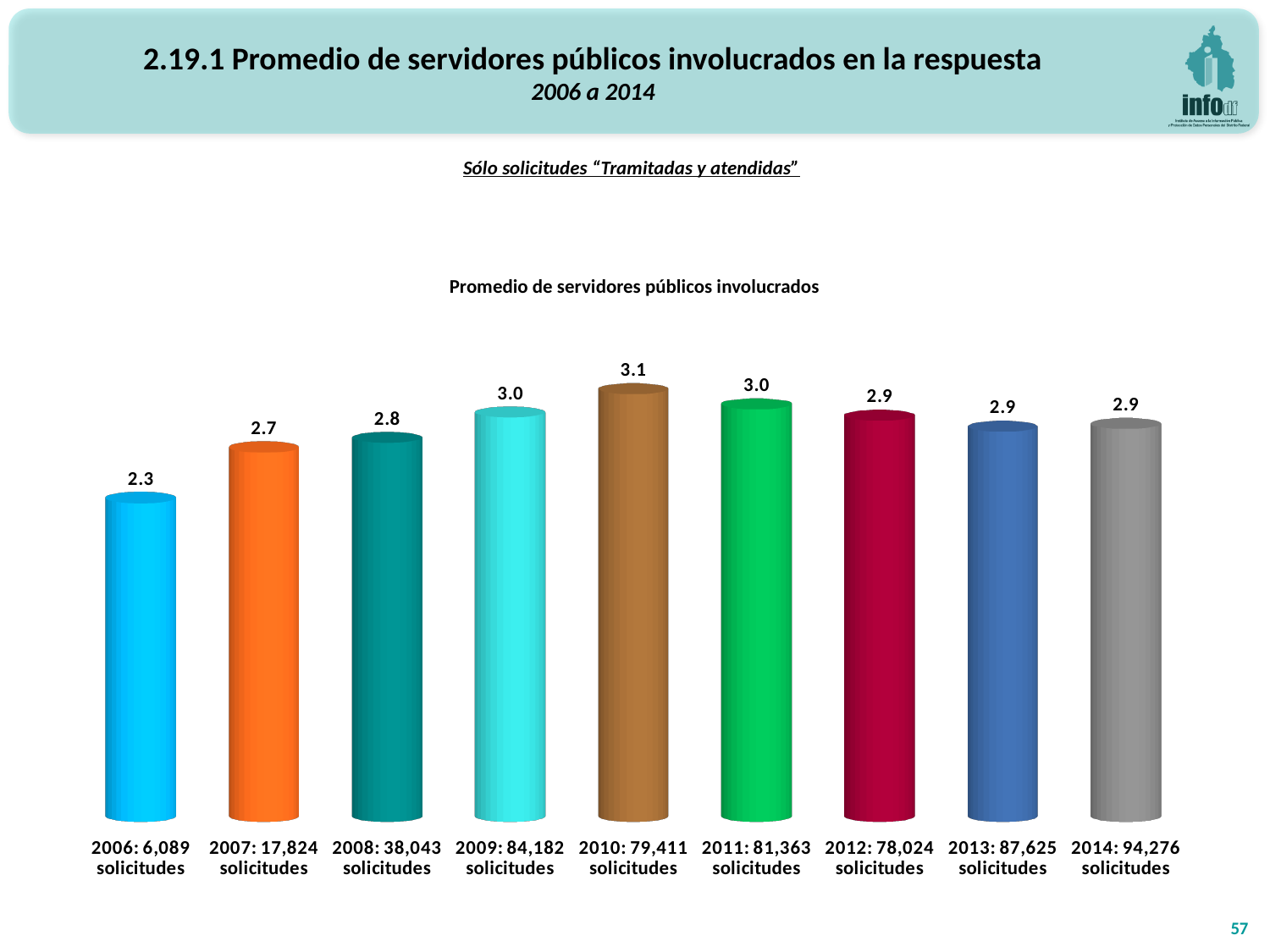
What is the value shown for 2008? 2.8 Do the values rise or fall from 2006 to 2010? Rise What is the difference between the values for 2010 and 2006? 0.8 How many years (bars) are shown in the chart? 9 Which year has the lowest average number of public servants involved? 2006 What is the average number of public servants involved for 2006? 2.3 Which is larger, the value for 2009 or the value for 2008? 2009 What kind of chart is shown on the slide? Bar chart What is the value shown for 2010? 3.1 What is the difference between the values for 2007 and 2006? 0.4 How many solicitudes are indicated in the category label for 2014? 94,276 Which year has the highest average number of public servants involved? 2010